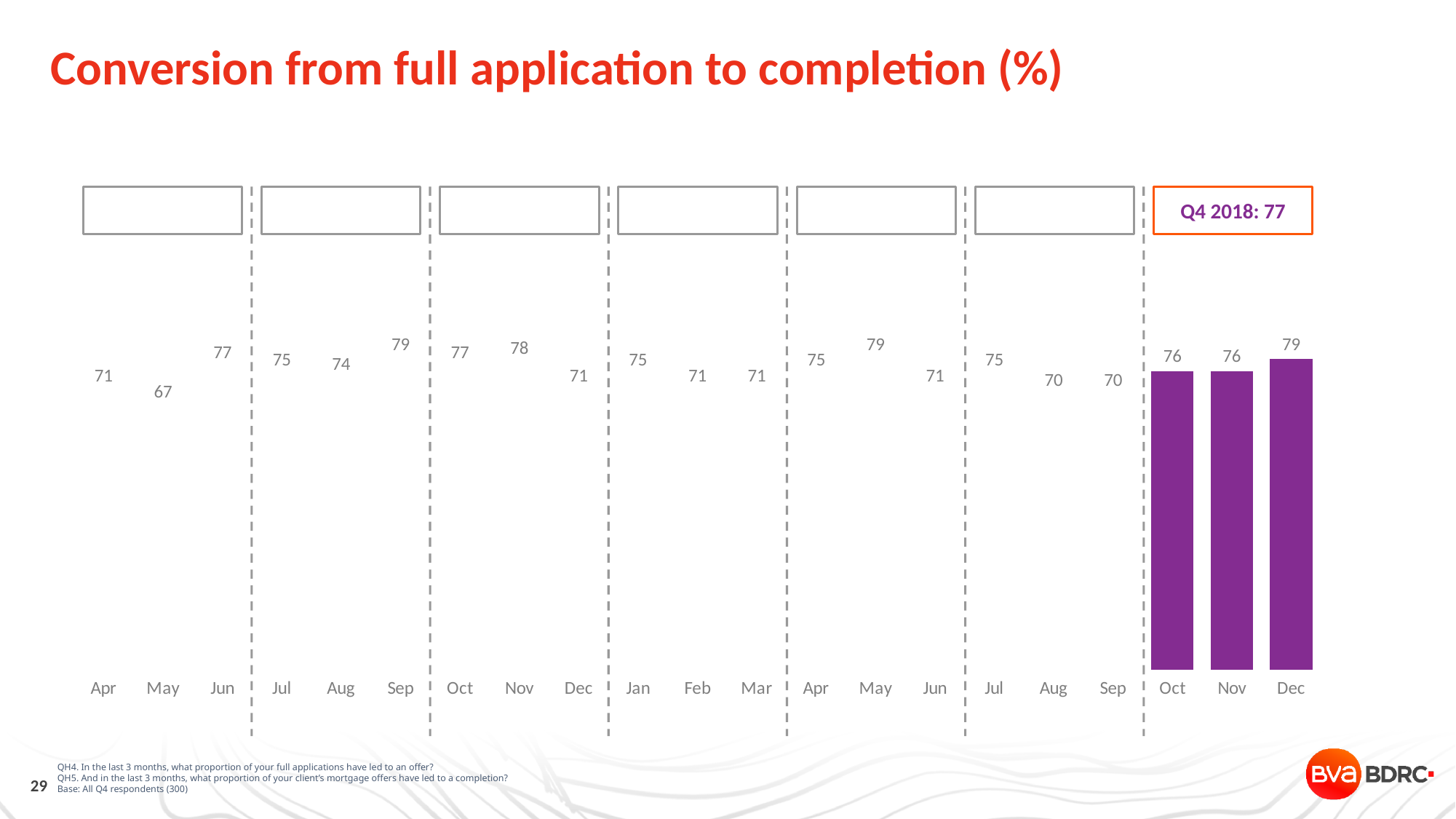
What is the difference between the Dec and Nov values in the purple bars at the right of the chart? 3 What is the value for Dec in the purple bars at the right of the chart? 79 What kind of chart is shown on the slide? bar chart What is the value for Jan on the chart? 75 What figure is given in the Q4 2018 box above the chart? 77 What is the value for Feb on the chart? 71 What is the value for Oct in the purple bars at the right of the chart? 76 What is the lowest value shown on the chart? 67 In the first quarter shown (Apr, May, Jun at the left), which month has the larger value, May or Jun? Jun How many months are shown along the x axis of the chart? 21 In the purple bars at the right, is the value for Dec higher or lower than the value for Oct? higher What is the highest value shown on the chart? 79